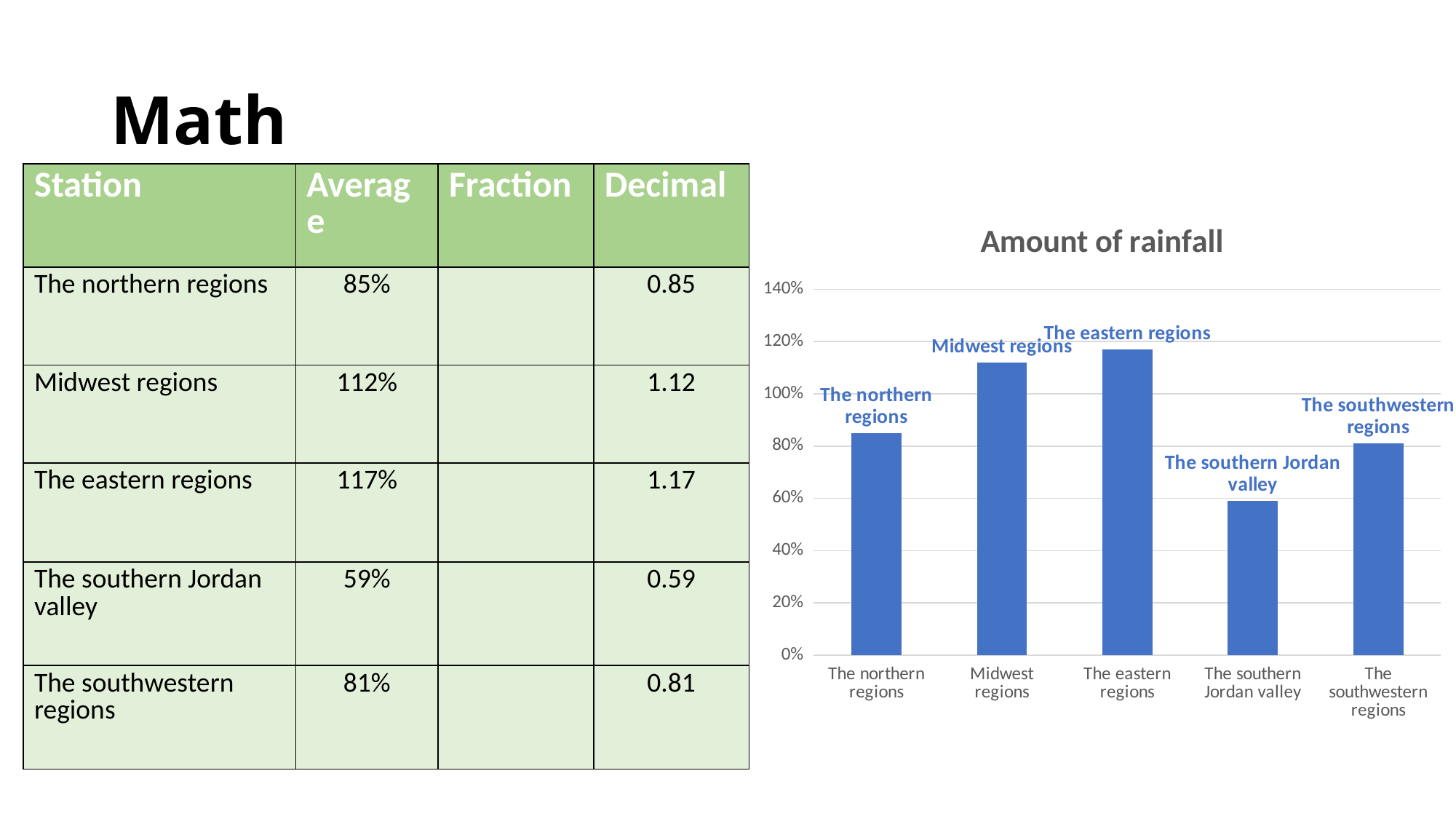
Which category has the lowest bar in the chart? The southern Jordan valley How many categories are plotted in the chart? 5 Is the value for The southern Jordan valley greater or less than 80%? less Is the value for The southwestern regions greater or less than 60%? greater Is the value for The northern regions greater or less than 100%? less Which category has the highest bar in the chart? The eastern regions What is the highest value shown on the vertical axis of the chart? 140% Which is larger, the value for The northern regions or the value for The southwestern regions? The northern regions What is the title of the chart? Amount of rainfall What kind of chart is shown on the slide? bar chart Which is larger, the value for The eastern regions or the value for The southern Jordan valley? The eastern regions